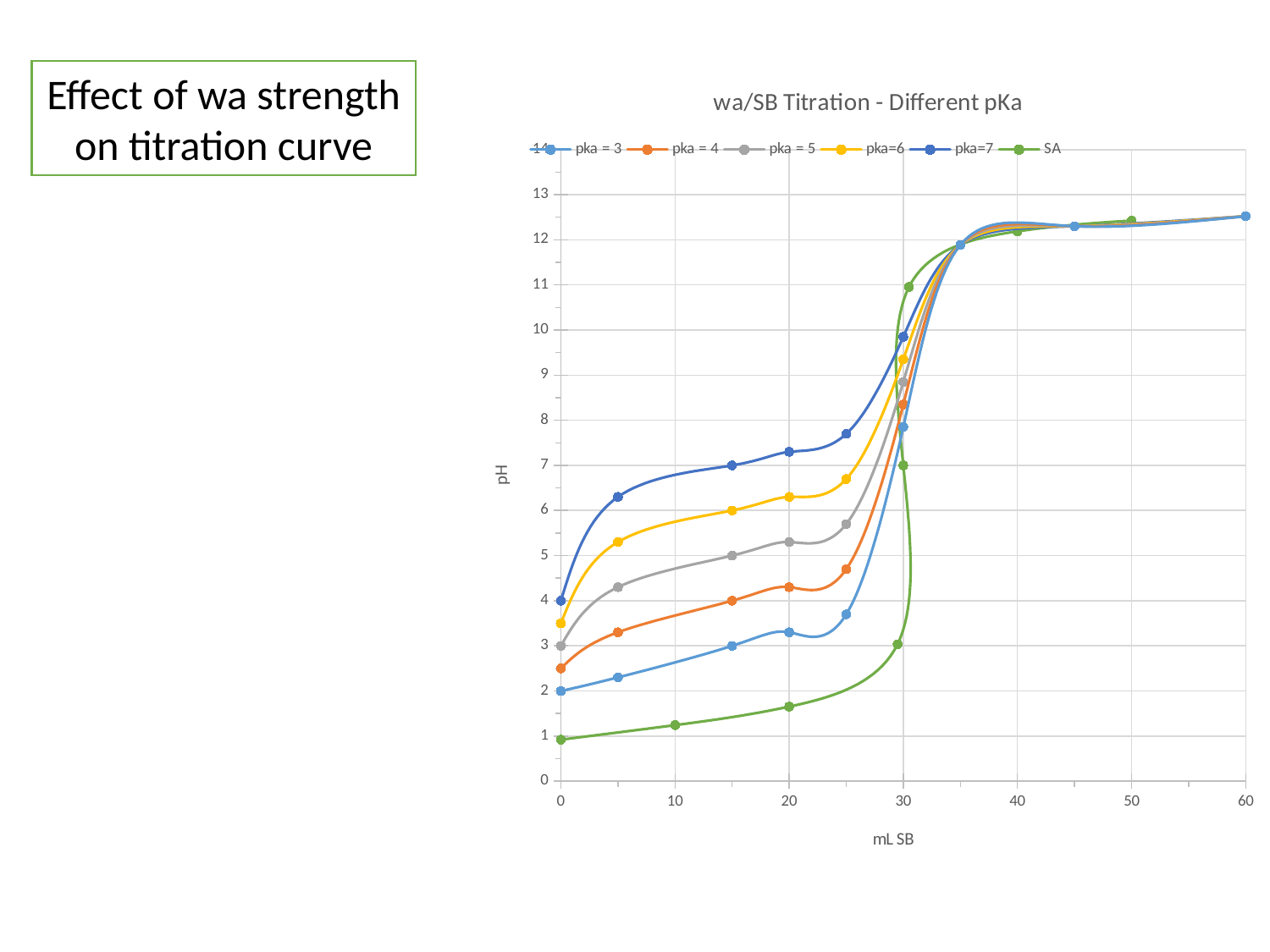
Does the pH of the pka = 4 series rise or fall as mL SB increases from 0 to 60? rise Which series has the lowest pH at 0 mL SB? SA What is the pH of the pka = 3 series at 0 mL SB? 2 At 0 mL SB, which series has the higher pH, pka=7 or pka = 3? pka=7 What is the pH of the pka = 5 series at 15 mL SB? 5 Is the pH of the SA series at 20 mL SB greater or less than 2? less What kind of chart is shown on the slide? line chart What is the label of the x axis? mL SB What is the pH of the pka=7 series at 0 mL SB? 4 What is the title of the chart? wa/SB Titration - Different pKa What is the pH of the pka=7 series at 15 mL SB? 7 How many series does the chart legend list? 6